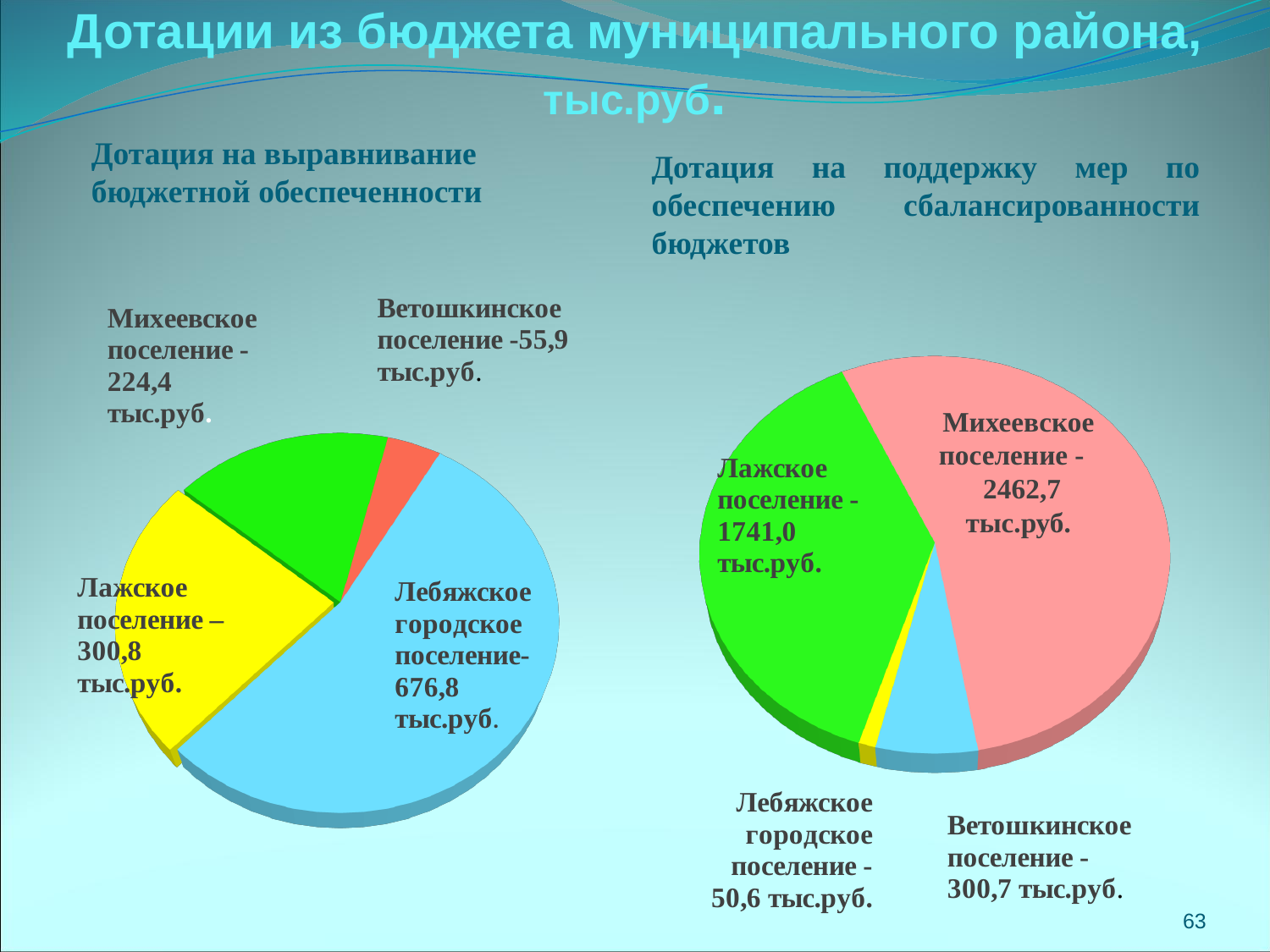
On the right pie chart (Дотация на поддержку мер по обеспечению сбалансированности бюджетов), what is the value for Лебяжское городское поселение? 50,6 тыс.руб. On the right pie chart (Дотация на поддержку мер по обеспечению сбалансированности бюджетов), what is the difference between Михеевское поселение and Лажское поселение? 721,7 тыс.руб. On the left pie chart (Дотация на выравнивание бюджетной обеспеченности), what is the value for Лебяжское городское поселение? 676,8 тыс.руб. On the left pie chart (Дотация на выравнивание бюджетной обеспеченности), which settlement has the largest value? Лебяжское городское поселение On the left pie chart (Дотация на выравнивание бюджетной обеспеченности), what is the value for Ветошкинское поселение? 55,9 тыс.руб. On the left pie chart (Дотация на выравнивание бюджетной обеспеченности), what is the difference between Лебяжское городское поселение and Лажское поселение? 376,0 тыс.руб. What type of chart is used on the left side of the slide (Дотация на выравнивание бюджетной обеспеченности)? Pie chart On the right pie chart (Дотация на поддержку мер по обеспечению сбалансированности бюджетов), what is the value for Лажское поселение? 1741,0 тыс.руб. On the right pie chart (Дотация на поддержку мер по обеспечению сбалансированности бюджетов), which settlement has the largest value? Михеевское поселение On the left pie chart (Дотация на выравнивание бюджетной обеспеченности), which is larger: Михеевское поселение or Лажское поселение? Лажское поселение On the right pie chart (Дотация на поддержку мер по обеспечению сбалансированности бюджетов), which settlement has the smallest value? Лебяжское городское поселение How many slices does the right pie chart (Дотация на поддержку мер по обеспечению сбалансированности бюджетов) have? 4